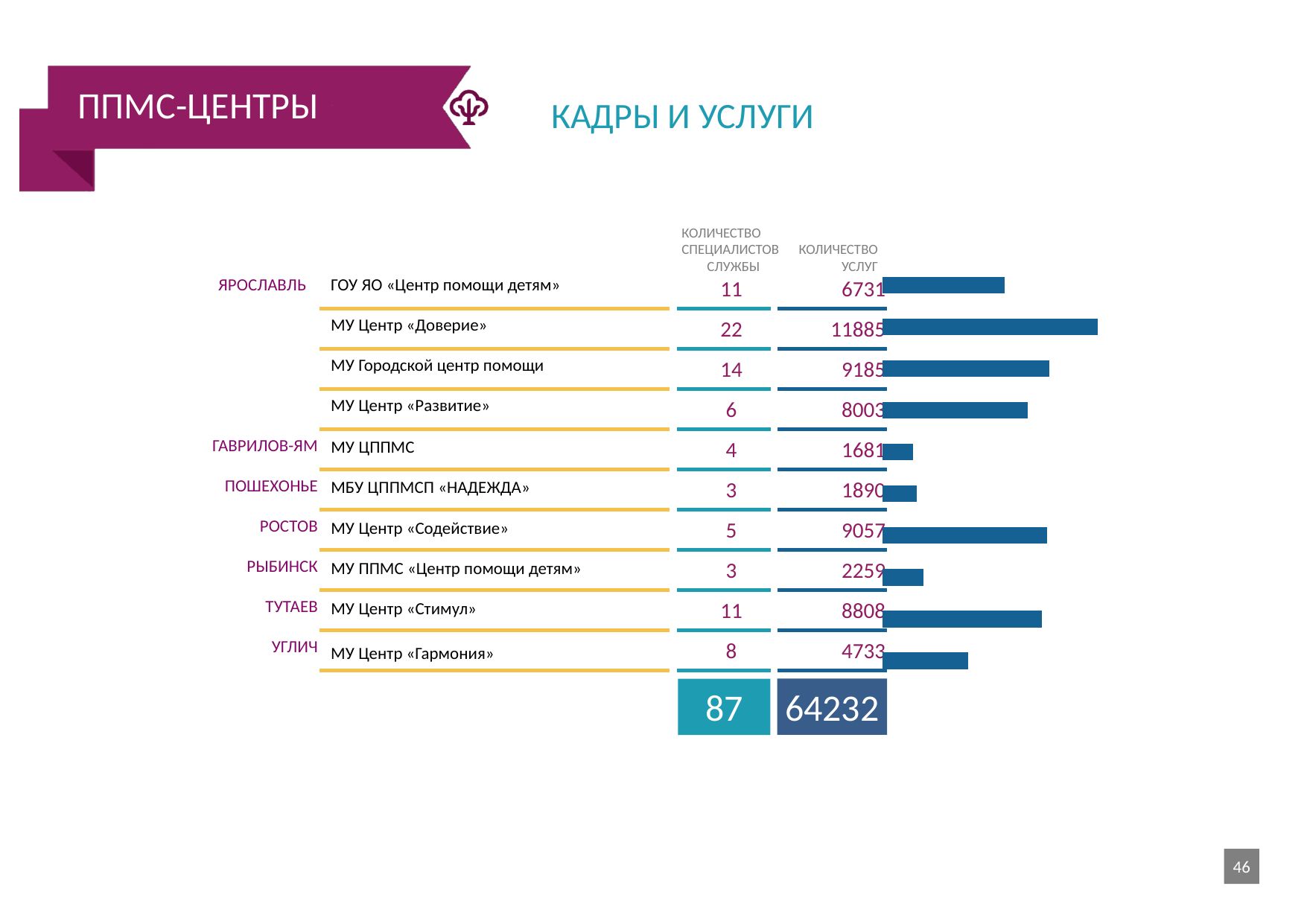
What is the 'Количество услуг' value for МУ ЦППМС (Гаврилов-Ям)? 1681 Which has a higher 'Количество услуг': МУ Центр «Содействие» or МУ Центр «Стимул»? МУ Центр «Содействие» What is the difference in 'Количество услуг' between МУ Центр «Доверие» and МУ Городской центр помощи? 2700 What is the 'Количество специалистов службы' value for МУ Центр «Развитие»? 6 What is the total 'Количество специалистов службы' shown at the bottom of the column? 87 What is the total 'Количество услуг' shown at the bottom of the column? 64232 Which center has the shortest bar (lowest 'Количество услуг')? МУ ЦППМС Which center has the longest bar (highest 'Количество услуг')? МУ Центр «Доверие» How many bars are plotted in the 'Количество услуг' chart? 10 What is the 'Количество услуг' value for МУ Центр «Доверие»? 11885 What kind of chart is shown next to the 'Количество услуг' column? bar chart What is the 'Количество услуг' value for МУ Центр «Гармония» (Углич)? 4733